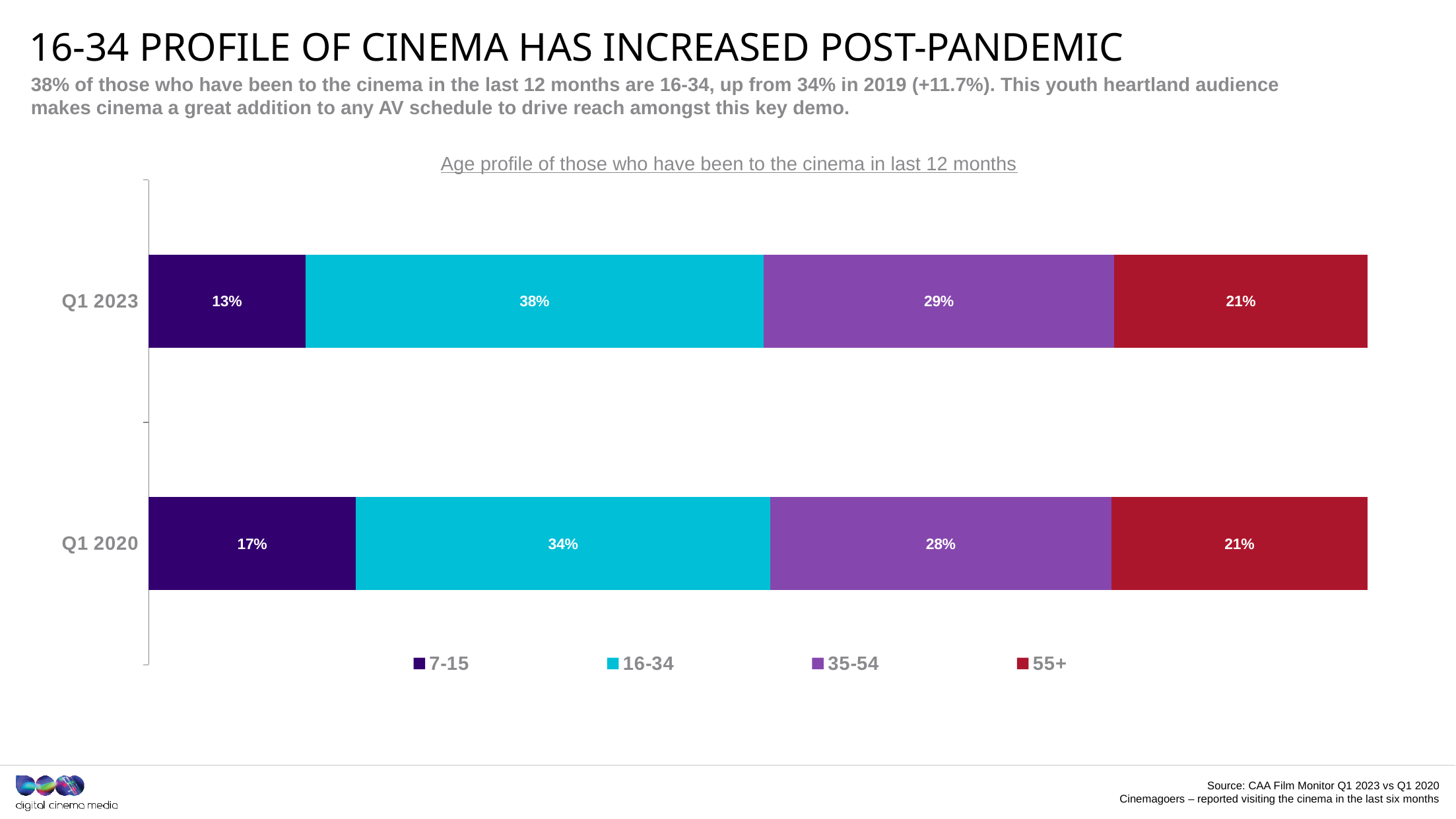
What kind of chart is shown on the slide? Stacked bar chart Which is larger: the 7-15 value in Q1 2020 or the 7-15 value in Q1 2023? Q1 2020 What is the value for the 55+ series in Q1 2020? 21% Which age group has the smallest share in the Q1 2023 bar? 7-15 What is the title of the chart? Age profile of those who have been to the cinema in last 12 months What is the value for the 35-54 series in Q1 2023? 29% Which age group has the largest share in the Q1 2023 bar? 16-34 What is the difference between the 16-34 value in Q1 2023 and in Q1 2020? 4% What is the value for the 16-34 series in Q1 2023? 38% How many series does the legend list? 4 What is the value for the 7-15 series in Q1 2020? 17% How many categories (bars) are shown on the chart? 2